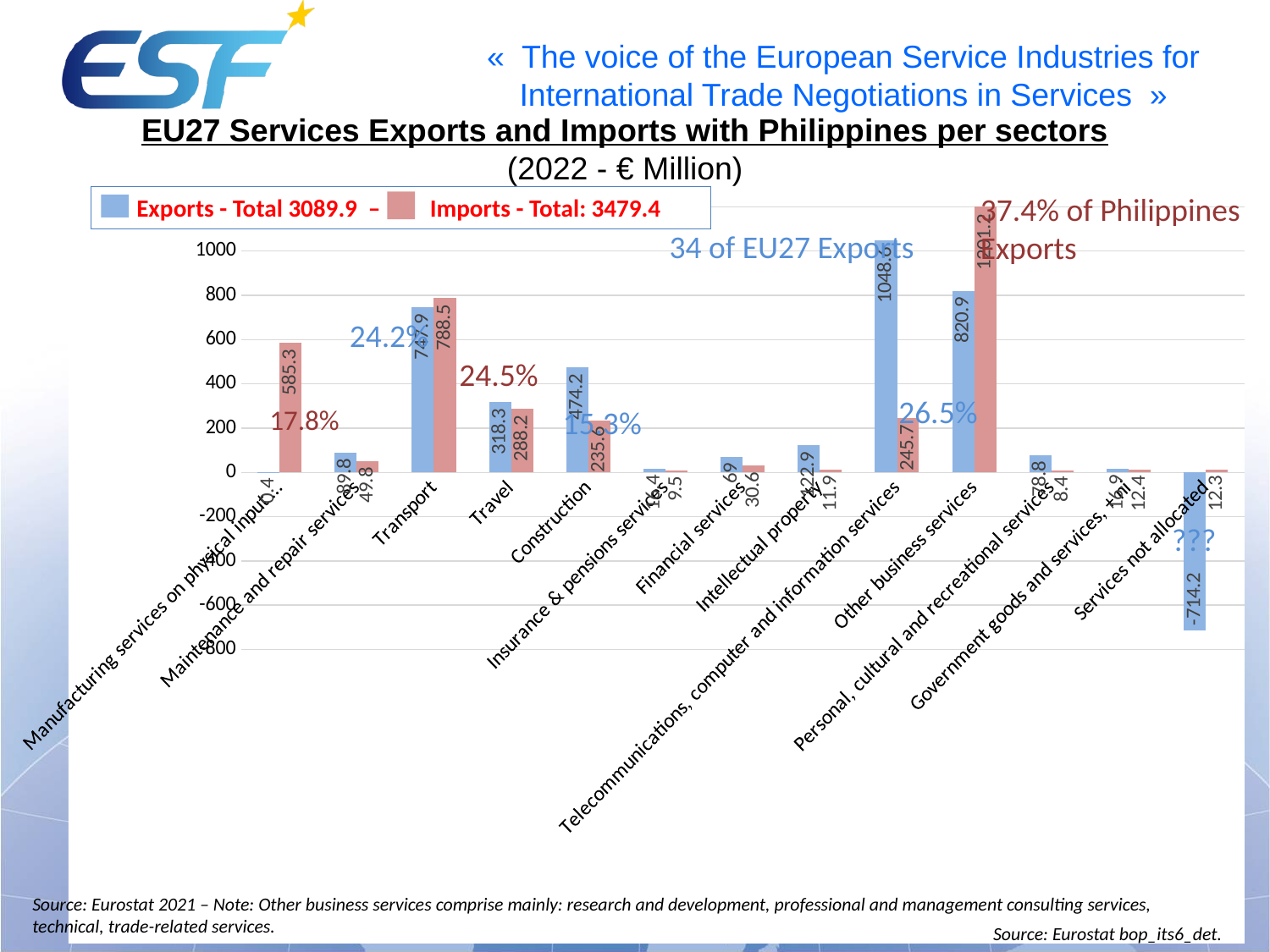
For Transport, which is larger: exports or imports? Imports Is the imports value for Manufacturing services on physical inputs greater or less than 400? greater Which sector has the lowest exports value? Services not allocated According to the legend, what is the total of exports? 3089.9 Which sector has the highest exports value? Telecommunications, computer and information services What is the value of EU27 exports to the Philippines for Transport? 747.9 What kind of chart is shown on the slide? bar chart What is the difference between exports and imports for Travel? 30.1 What is the exports value for Telecommunications, computer and information services? 1048.6 What is the value of EU27 imports from the Philippines for Transport? 788.5 How many series does the legend list? 2 What is the imports value for Construction? 235.6